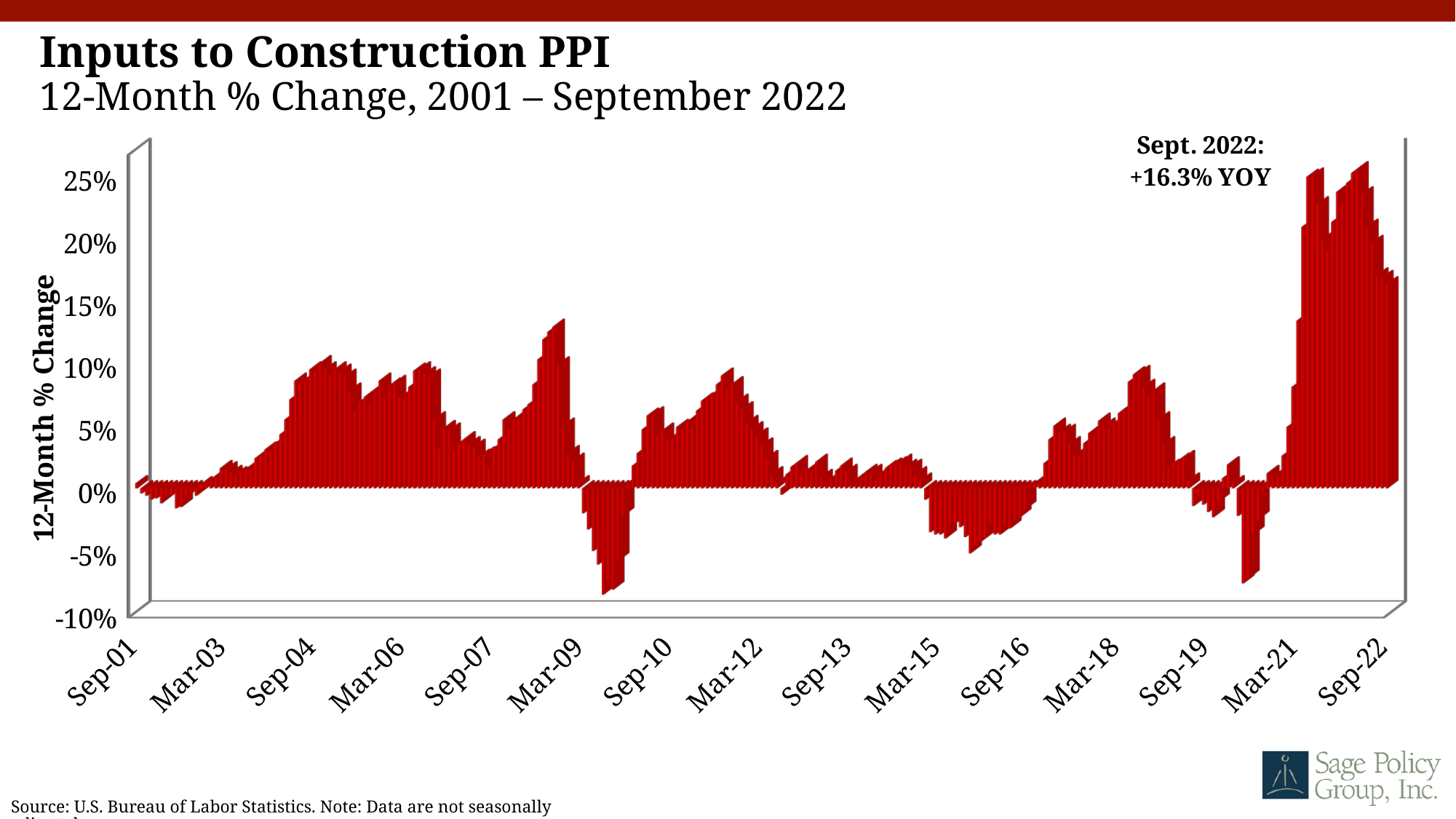
What kind of chart is shown on the slide? bar chart Is the value for Sep-22 greater or less than 15%? greater What is the 12-month % change for September 2022 shown on the chart? +16.3% YOY Is the peak value reached in 2008 greater or less than 10%? greater Do the values rise or fall between Sep-01 and Sep-04? rise What is the source of the data cited on the slide? U.S. Bureau of Labor Statistics Is the lowest value reached in 2009 greater or less than -5%? less Which x-axis label is closest to the tallest bars on the chart? Sep-22 In which year do the most negative values on the chart occur? 2009 What is the title of the y axis? 12-Month % Change How many date labels are shown on the x axis? 15